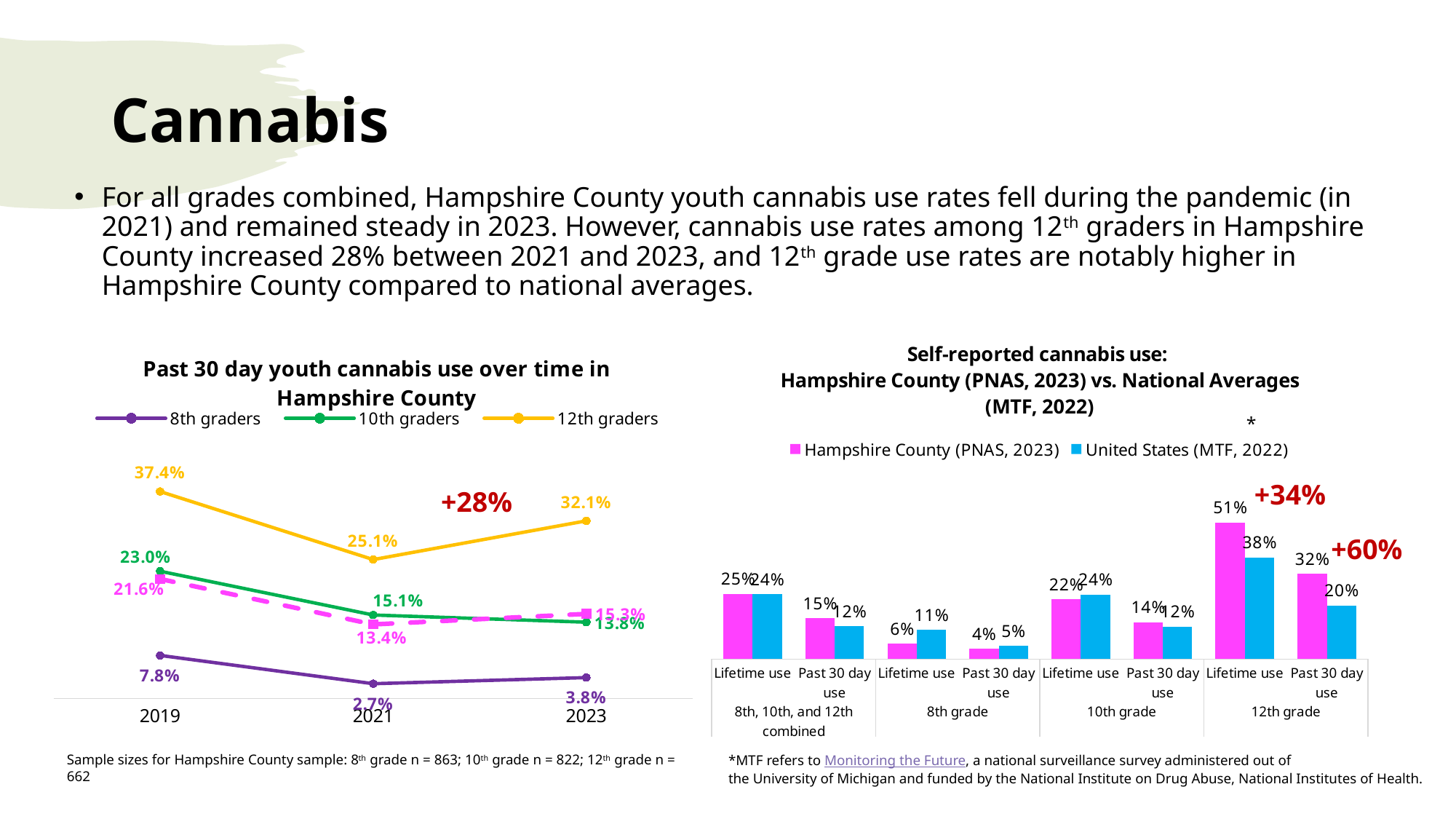
How many series does the legend of the 'Past 30 day youth cannabis use over time in Hampshire County' chart list? 3 In the 'Self-reported cannabis use' bar chart, what is the United States (MTF, 2022) value for 8th grade lifetime use? 11% In the 'Self-reported cannabis use' bar chart, what is the difference between the Hampshire County and United States values for 12th grade past 30 day use? 12% In the 'Self-reported cannabis use' bar chart, which category has the highest Hampshire County (PNAS, 2023) value? 12th grade lifetime use In the 'Past 30 day youth cannabis use over time in Hampshire County' chart, what was the value for 12th graders in 2019? 37.4% What kind of chart is the 'Self-reported cannabis use: Hampshire County (PNAS, 2023) vs. National Averages (MTF, 2022)' chart? bar chart In the 'Past 30 day youth cannabis use over time in Hampshire County' chart, which year had the lowest value for 10th graders? 2023 In the 'Self-reported cannabis use' bar chart, what is the Hampshire County (PNAS, 2023) value for 12th grade lifetime use? 51% In the 'Past 30 day youth cannabis use over time in Hampshire County' chart, what is the difference between the 12th grader values in 2023 and 2021? 7.0% In the 'Self-reported cannabis use' bar chart, which is larger for 12th grade past 30 day use: Hampshire County (PNAS, 2023) or United States (MTF, 2022)? Hampshire County (PNAS, 2023) In the 'Past 30 day youth cannabis use over time in Hampshire County' chart, what was the value for 8th graders in 2021? 2.7% In the 'Past 30 day youth cannabis use over time in Hampshire County' chart, did the 10th grader values rise or fall from 2019 to 2023? fall